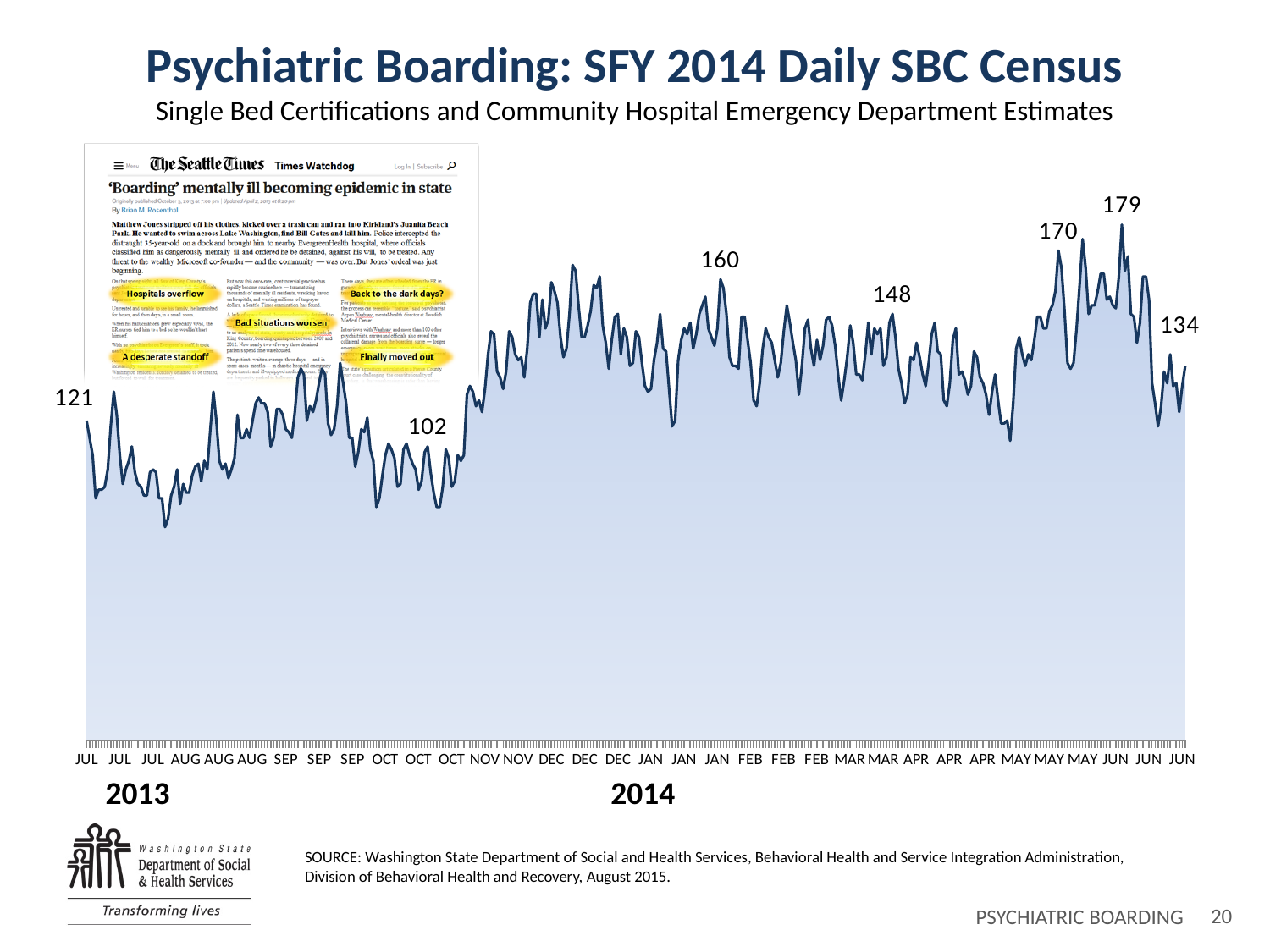
What is the first labeled value on the chart, at the start of the series in July 2013? 121 Which labeled value is larger, the one near January 2014 or the one near March 2014? January 2014 (160) What is the difference between the labeled peak of 179 and the final value of 134? 45 What is the highest labeled value on the chart? 179 What is the difference between the peak labeled value of 179 and the starting value of 121? 58 Which is larger, the value at the start of the series (July 2013) or the value at the end of the series (June 2014)? The end of the series (134) What is the lowest labeled value on the chart? 102 What is the last labeled value on the chart, at the end of the series in June 2014? 134 What is the difference between the labeled values 170 and 160? 10 Which two years are labeled along the x axis of the chart? 2013 and 2014 What is the title of the chart on the slide? Psychiatric Boarding: SFY 2014 Daily SBC Census What kind of chart is shown on the slide? Line chart